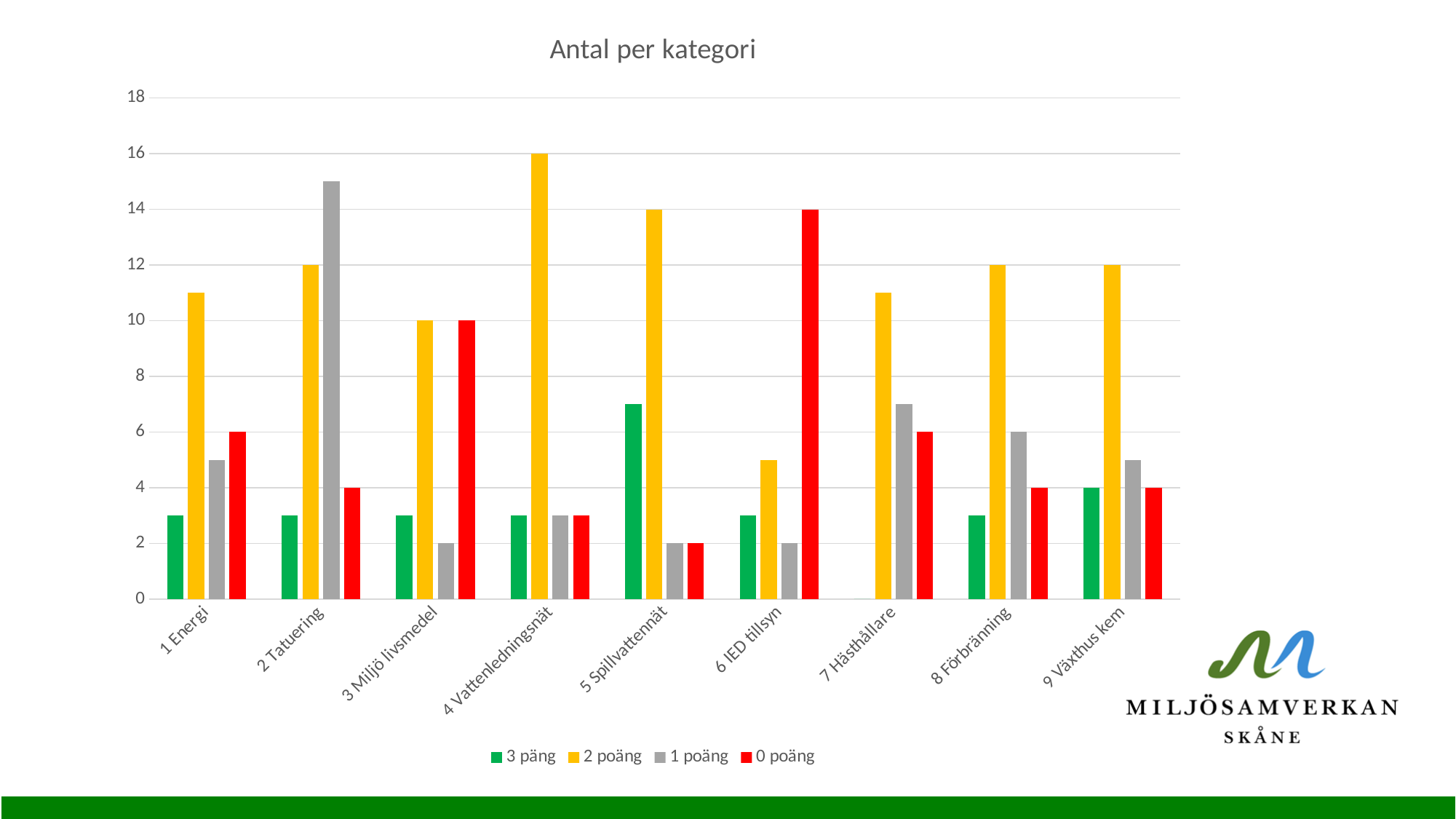
How many categories are shown on the x axis? 9 Is the 1 poäng value for 2 Tatuering greater or less than 14? greater What is the title of the chart? Antal per kategori Which category has the lowest value in the 2 poäng series? 6 IED tillsyn What type of chart is shown on the slide? bar chart Which category has the highest value in the 2 poäng series? 4 Vattenledningsnät What is the value of the 2 poäng series for 4 Vattenledningsnät? 16 What is the value of the 2 poäng series for 2 Tatuering? 12 What is the difference between the 2 poäng values for 4 Vattenledningsnät and 5 Spillvattennät? 2 What is the value of the 0 poäng series for 6 IED tillsyn? 14 How many series does the legend list? 4 Which is larger: the 0 poäng value for 6 IED tillsyn or for 1 Energi? 6 IED tillsyn